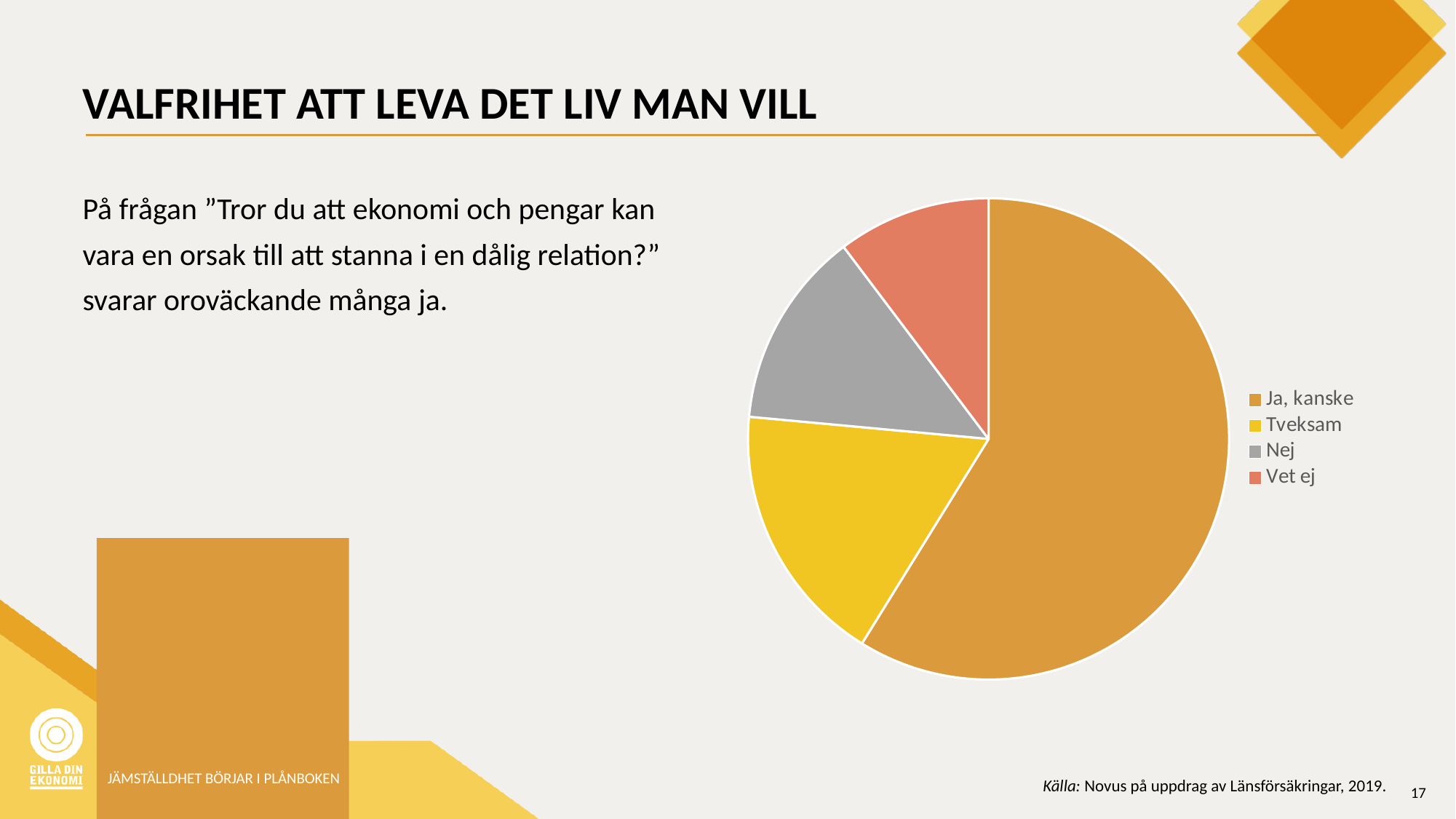
How many entries does the legend of the pie chart list? 4 Which category has the largest slice in the pie chart? Ja, kanske Which slice is larger in the pie chart, Nej or Vet ej? Nej Which slice is larger in the pie chart, Tveksam or Nej? Tveksam Which slice is larger in the pie chart, Ja, kanske or Tveksam? Ja, kanske How many slices does the pie chart have? 4 What kind of chart is shown on the slide? Pie chart What colour is the Nej slice in the pie chart? Gray Which category has the smallest slice in the pie chart? Vet ej Which legend entry is shown in yellow in the pie chart? Tveksam Does the Ja, kanske slice cover more or less than half of the pie chart? more